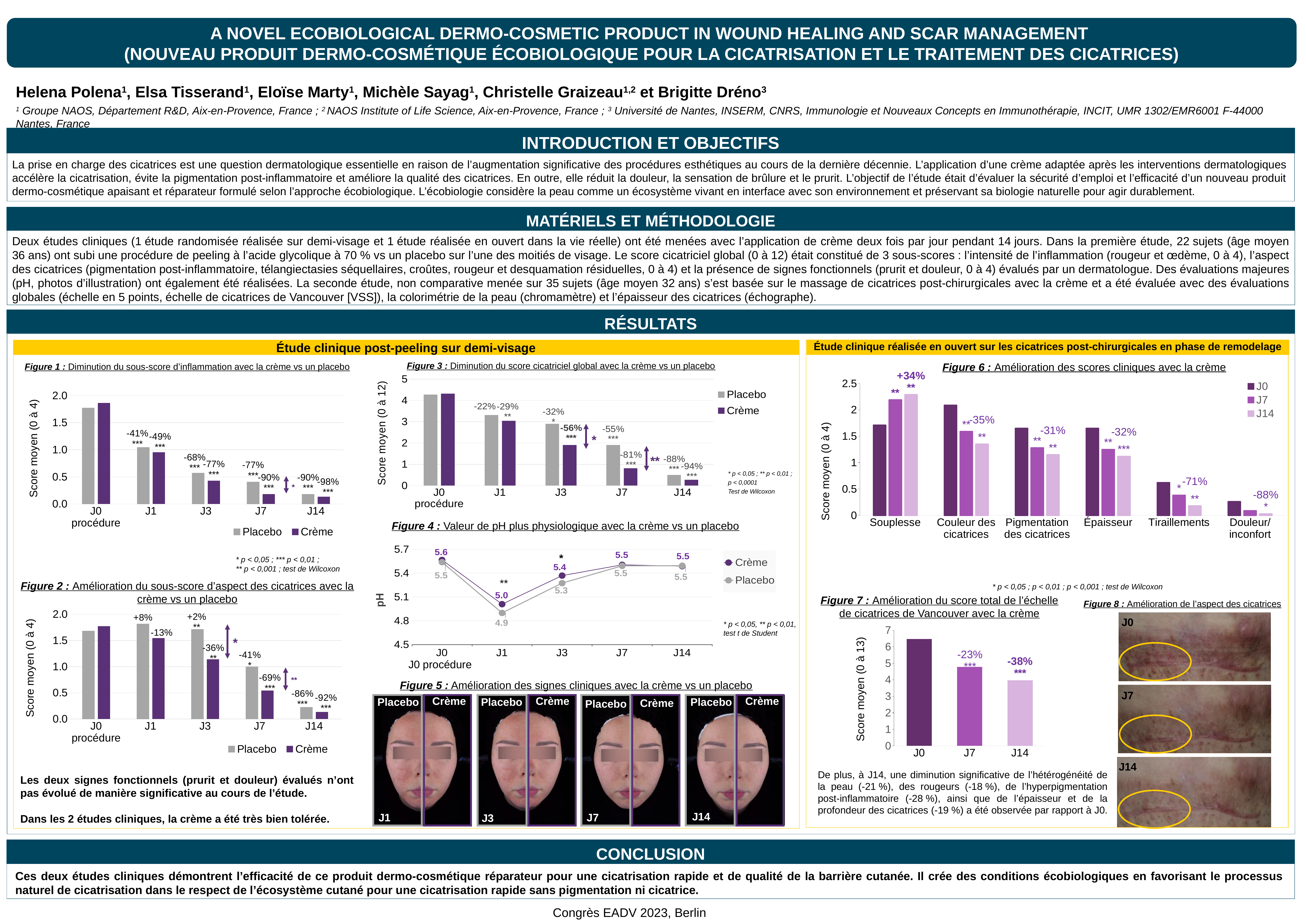
In Figure 2, which is higher at J3, Placebo or Crème? Placebo In Figure 4, what is the pH value for Placebo at J1? 4.9 In Figure 4, does the Crème pH rise or fall from J0 procédure to J1? fall How many series does the legend of Figure 6 list? 3 In Figure 7, what percentage change is labelled for J14? -38% In Figure 6, is the J14 value for Souplesse greater or less than 2? greater In Figure 7, is the value for J0 greater or less than 6? greater In Figure 4, what is the difference between the Crème and Placebo pH values at J3? 0.1 How many categories are shown on the x axis of Figure 6? 6 In Figure 4, what is the pH value for Crème at J1? 5.0 In Figure 6, what percentage change is labelled for Tiraillements? -71% What kind of chart is Figure 4? line chart